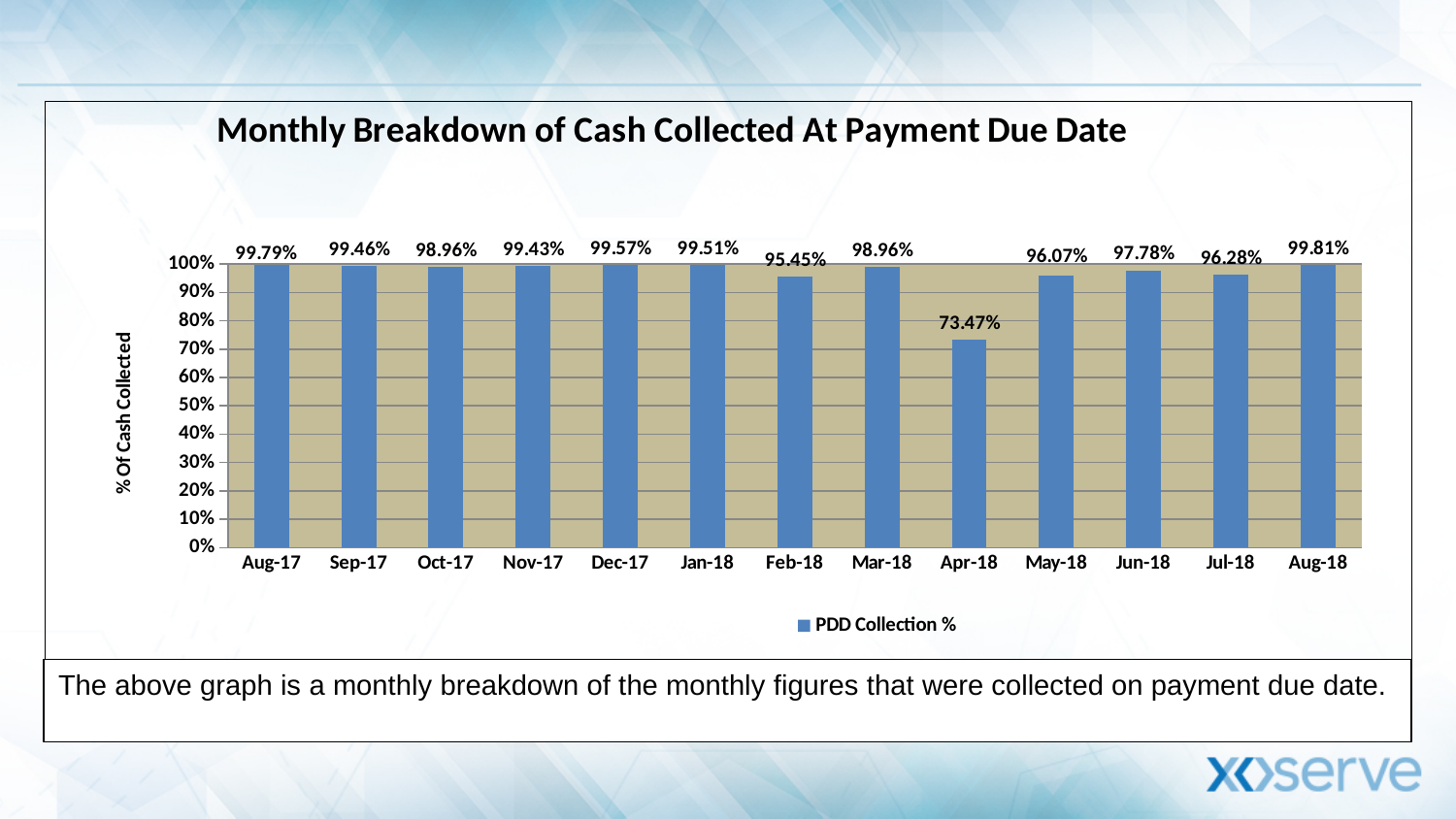
What kind of chart is shown on the slide? Bar chart What is the title of the chart? Monthly Breakdown of Cash Collected At Payment Due Date Is the value for Apr-18 greater or less than 80%? less Which month has the highest PDD Collection %? Aug-18 Which is larger, the PDD Collection % for May-18 or Jun-18? Jun-18 What is the PDD Collection % for Apr-18? 73.47% How many series does the legend list? 1 What is the difference between the PDD Collection % for Aug-18 and Apr-18? 26.34% What is the PDD Collection % for Aug-17? 99.79% What is the PDD Collection % for Feb-18? 95.45% Which month has the lowest PDD Collection %? Apr-18 How many months are shown on the x axis? 13